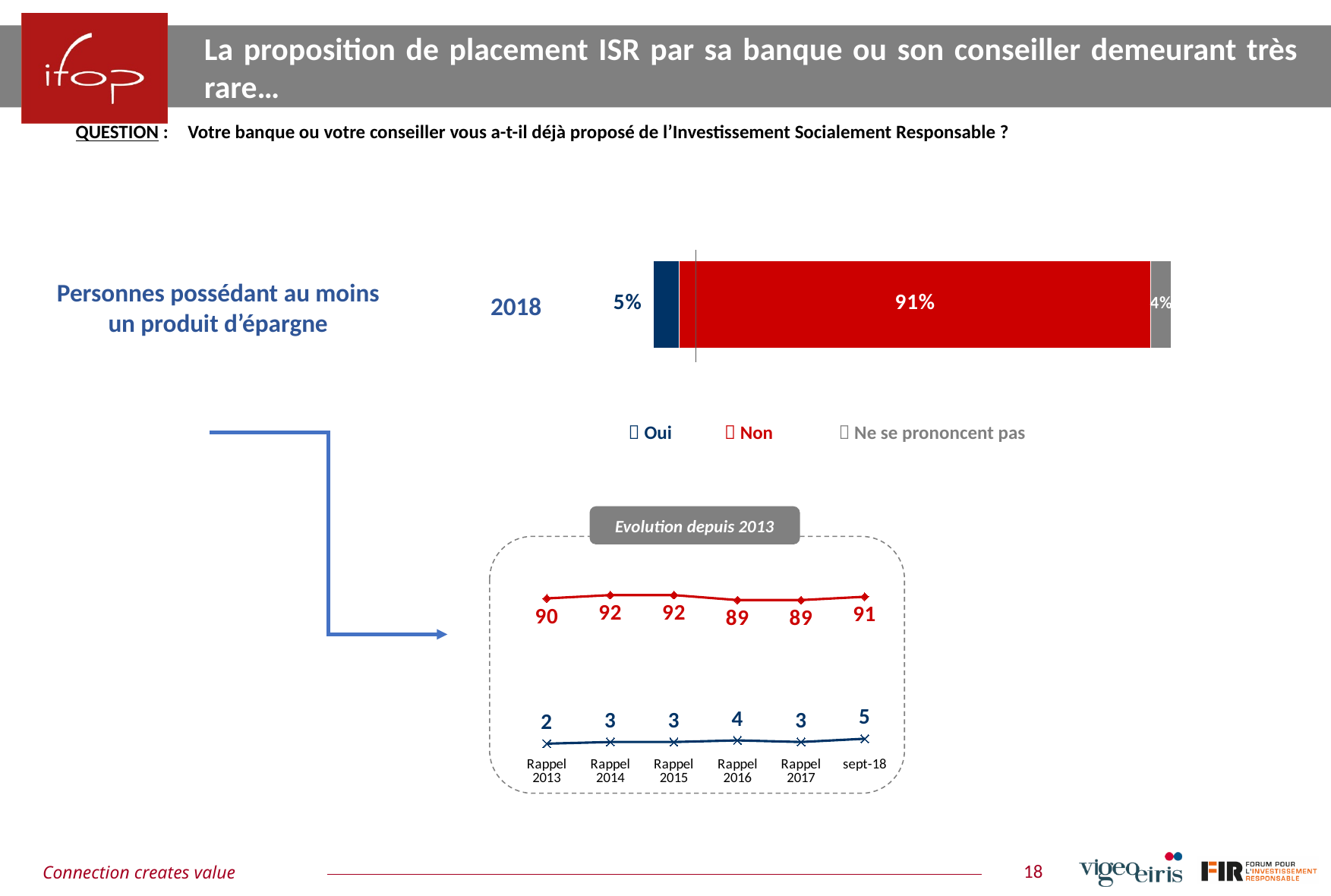
In the "Evolution depuis 2013" chart, what is the value of the blue line for sept-18? 5 In the 2018 stacked bar chart, what percentage answered "Non"? 91% In the 2018 stacked bar chart, what is the difference between the "Non" and "Oui" percentages? 86% What kind of chart is the "Evolution depuis 2013" chart? Line chart In the "Evolution depuis 2013" chart, what is the value of the red line for Rappel 2016? 89 In the "Evolution depuis 2013" chart, how many time points are plotted on the x axis? 6 In the 2018 stacked bar chart, what percentage answered "Oui"? 5% In the "Evolution depuis 2013" chart, at which time point is the blue line lowest? Rappel 2013 In the 2018 stacked bar chart, which response has the largest share? Non In the "Evolution depuis 2013" chart, at which time point does the blue line reach its highest value? sept-18 In the 2018 stacked bar chart, what percentage is "Ne se prononcent pas"? 4% In the 2018 stacked bar chart, how many series does the legend list? 3